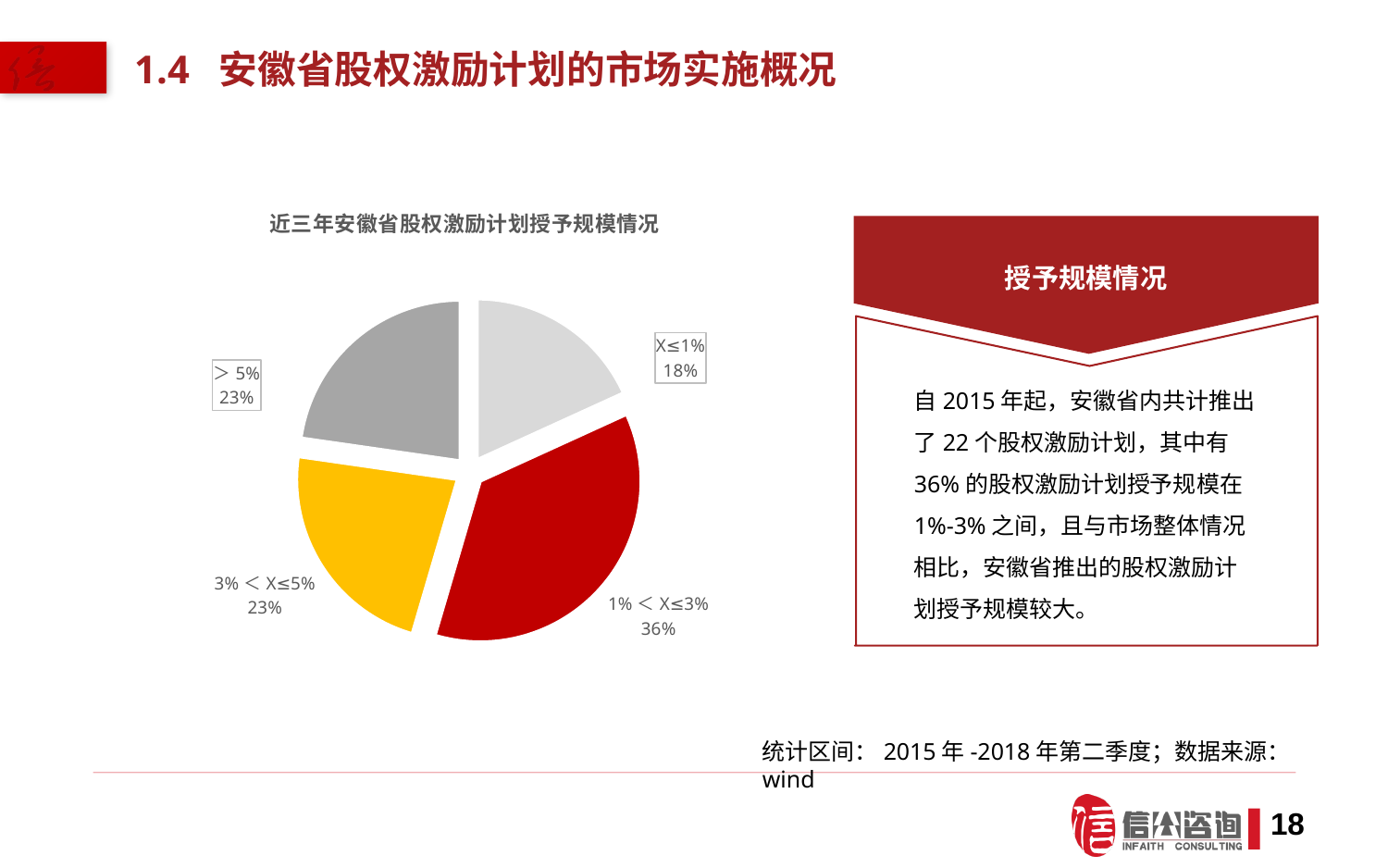
Which has a larger share: the 1%＜X≤3% category or the ＞5% category? 1%＜X≤3% Which category has the smallest share of the pie? X≤1% What is the difference in share between the 1%＜X≤3% category and the X≤1% category? 18% What kind of chart is shown on the slide? pie chart What share of the pie does the X≤1% category take? 18% What share of the pie does the 3%＜X≤5% category take? 23% How many slices does the pie chart have? 4 What colour is the slice for the 3%＜X≤5% category? yellow Which category has the largest share of the pie? 1%＜X≤3% What share of the pie does the 1%＜X≤3% category take? 36% What is the title of the chart? 近三年安徽省股权激励计划授予规模情况